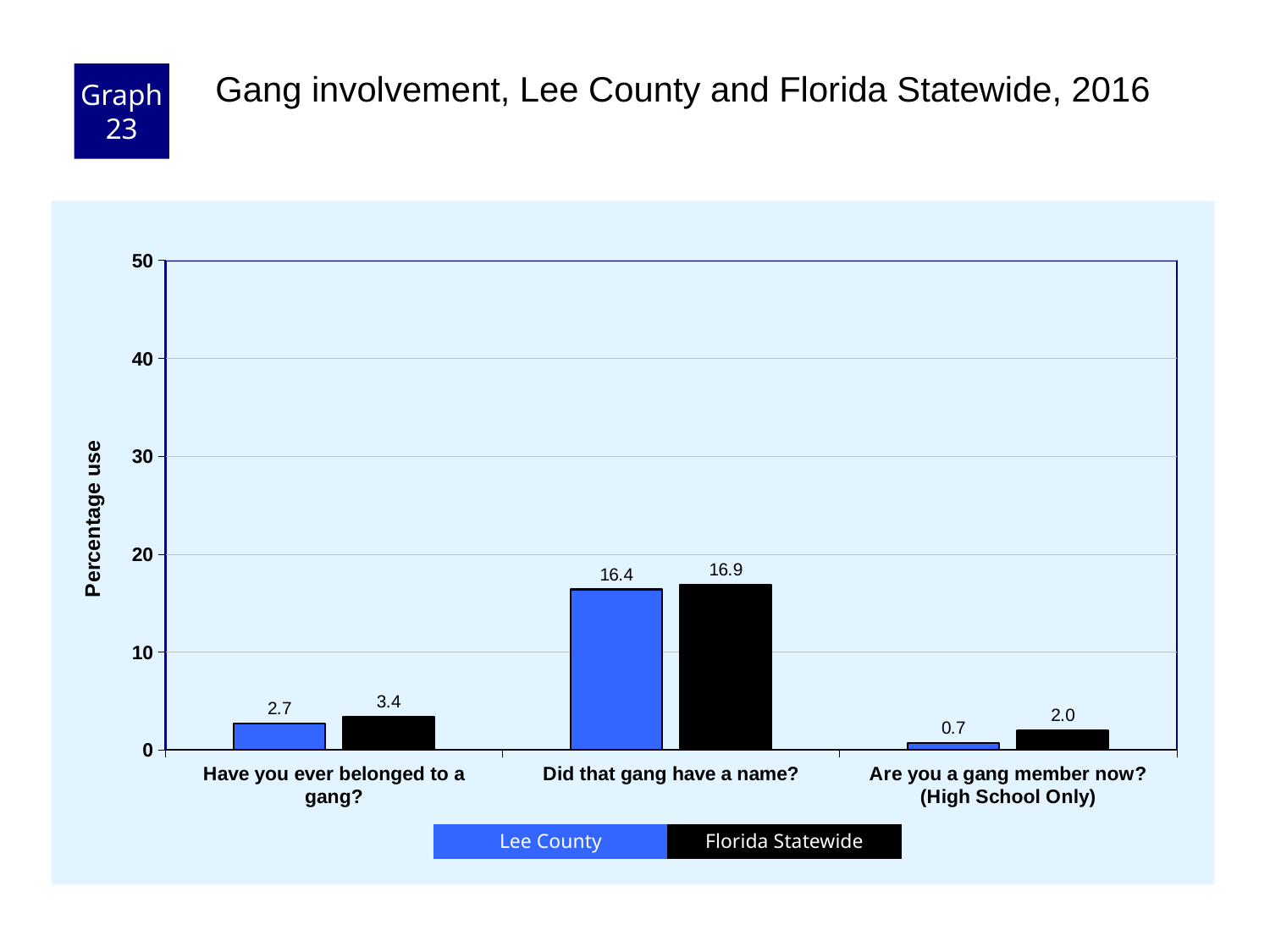
What is the Lee County value for "Are you a gang member now? (High School Only)"? 0.7 What kind of chart is shown on the slide? Bar chart Which question has the lowest Florida Statewide value? Are you a gang member now? (High School Only) How many series does the legend list? 2 What is the Lee County value for "Have you ever belonged to a gang?"? 2.7 Is the Lee County value for "Did that gang have a name?" greater or less than 20? less For "Are you a gang member now? (High School Only)", which is larger: Lee County or Florida Statewide? Florida Statewide How many questions (categories) are shown on the x axis? 3 What is the Florida Statewide value for "Did that gang have a name?"? 16.9 What is the difference between the Florida Statewide and Lee County values for "Did that gang have a name?"? 0.5 What is the Florida Statewide value for "Have you ever belonged to a gang?"? 3.4 Which question has the highest Lee County value? Did that gang have a name?